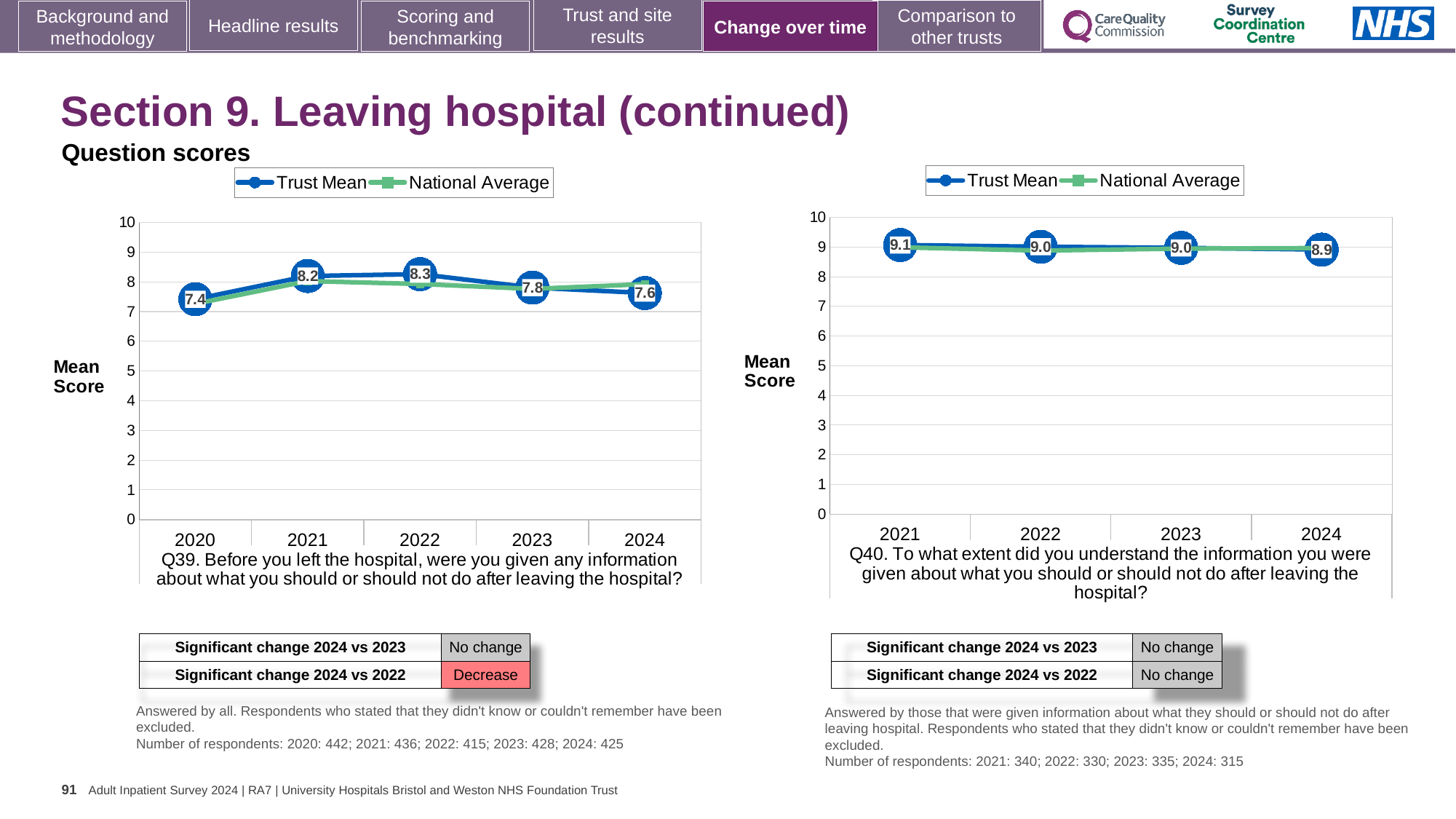
In the Q39 chart on the left, what is the Trust Mean score for 2020? 7.4 In the Q39 chart on the left, what is the difference between the Trust Mean scores for 2022 and 2024? 0.7 In the Q39 chart on the left, which year has the lowest Trust Mean score? 2020 In the Q40 chart on the right, does the Trust Mean score rise or fall from 2021 to 2024? Fall In the Q40 chart on the right, is the Trust Mean score for 2023 greater or less than 8? greater What kind of chart is the Q40 chart on the right? Line chart In the Q40 chart on the right, how many series does the legend list? 2 In the Q39 chart on the left, which year has the highest Trust Mean score? 2022 In the Q40 chart on the right, what is the Trust Mean score for 2024? 8.9 In the Q40 chart on the right, what is the Trust Mean score for 2021? 9.1 In the Q39 chart on the left, how many years are plotted on the x axis? 5 In the Q39 chart on the left, what is the Trust Mean score for 2022? 8.3